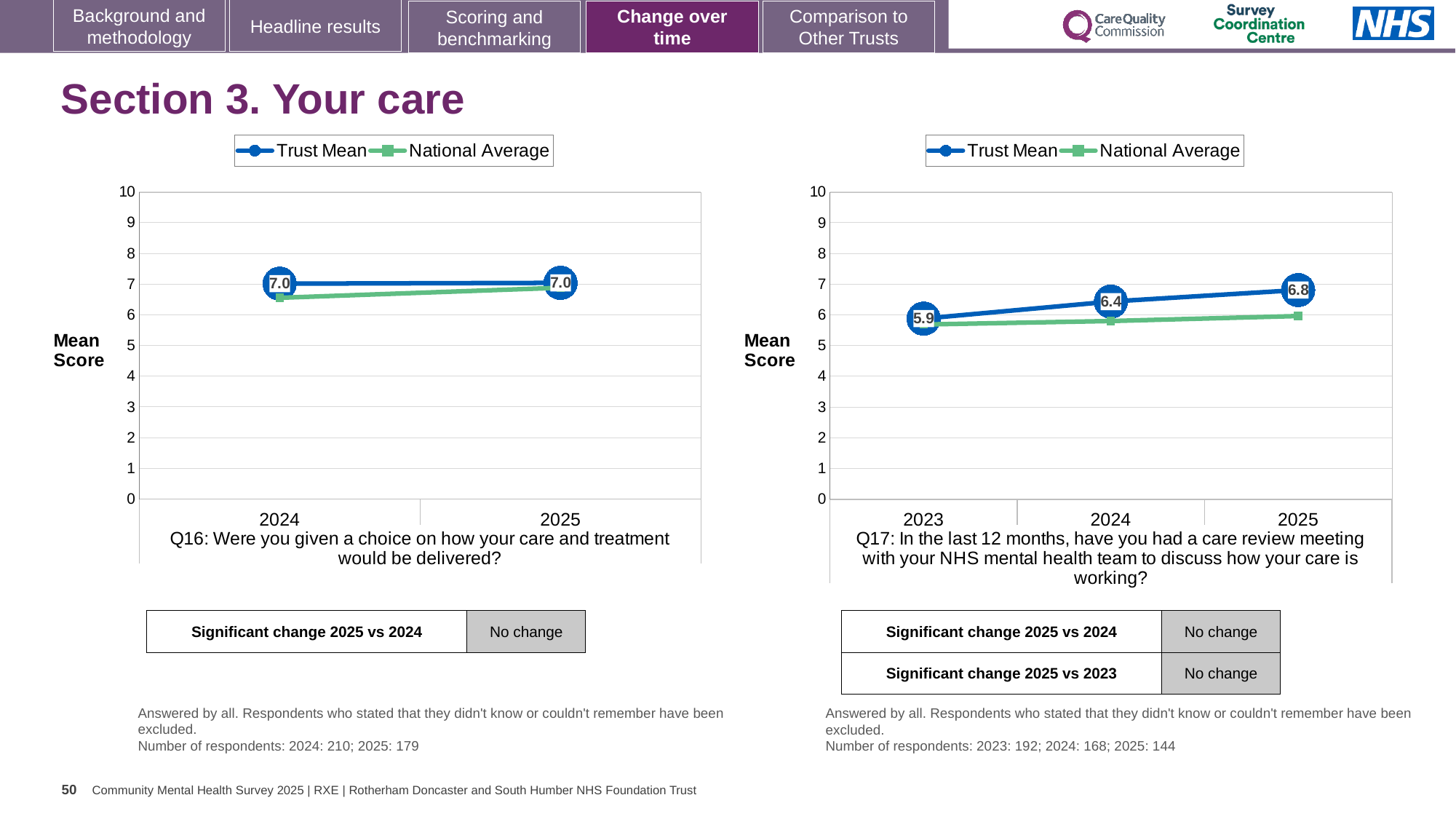
What kind of chart is the left chart (Q16)? line chart In the right chart (Q17), does the Trust Mean rise or fall from 2023 to 2025? rise In the right chart (Q17), which year has the highest Trust Mean? 2025 In the right chart (Q17), which year has the lowest Trust Mean? 2023 In the right chart (Q17), what is the difference between the Trust Mean for 2025 and the Trust Mean for 2023? 0.9 In the right chart (Q17), what is the Trust Mean for 2025? 6.8 How many years are shown on the x axis of the right chart (Q17)? 3 In the left chart (Q16), what is the Trust Mean for 2024? 7.0 In the right chart (Q17), what is the Trust Mean for 2023? 5.9 In the right chart (Q17), is the National Average for 2025 greater or less than 7? less How many series does the legend of the left chart (Q16) list? 2 In the left chart (Q16), what is the Trust Mean for 2025? 7.0